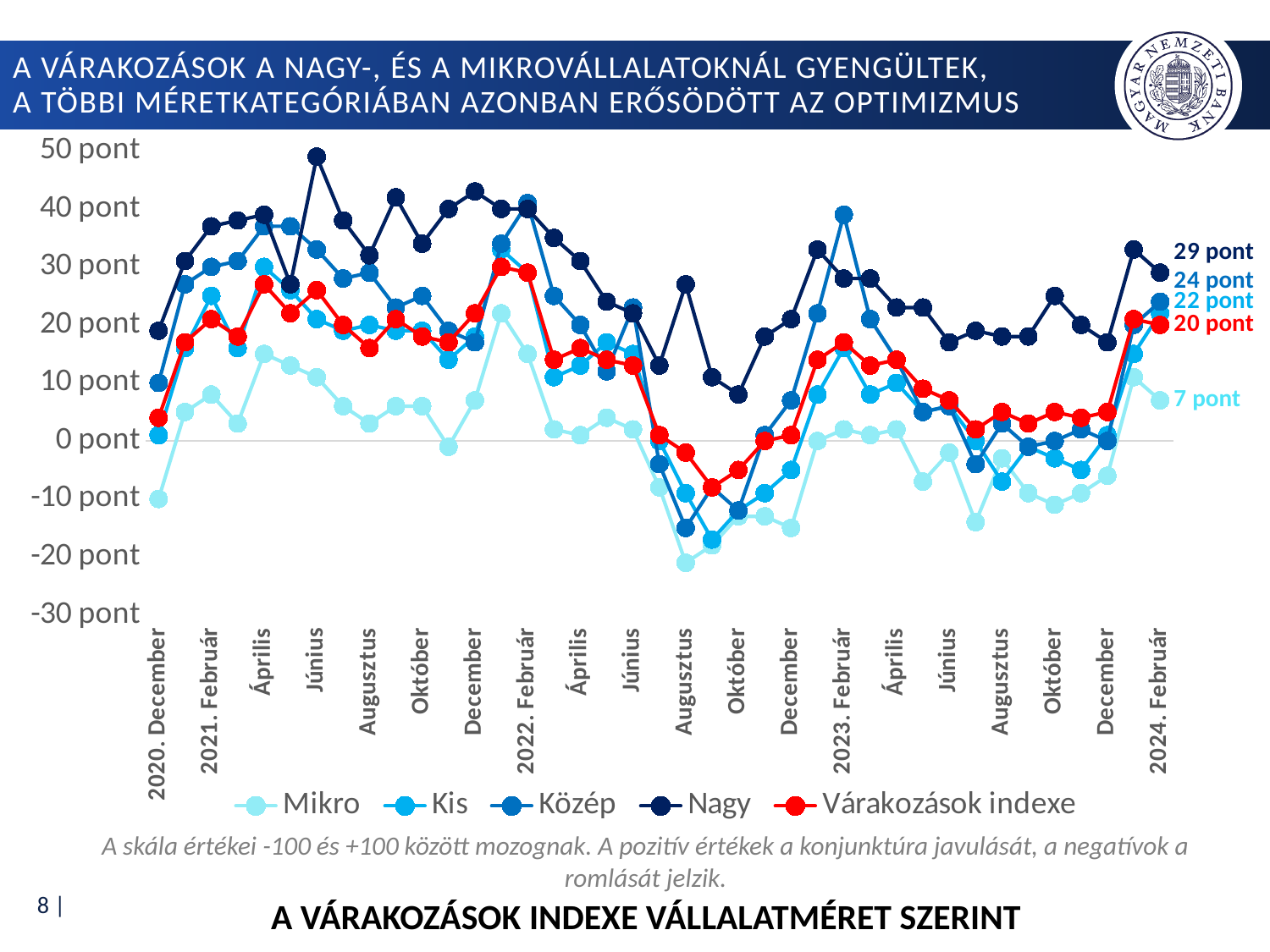
What is the value of the Várakozások indexe series at 2024. Február? 20 pont What kind of chart is shown on the slide? Line chart What is the difference between the Nagy and Mikro values at 2024. Február? 22 pont What is the value of the Mikro series at 2024. Február? 7 pont Is the value for Mikro at 2020. December greater or less than 0 pont? less Which series has the highest value at 2024. Február? Nagy Which series has the lowest value at 2024. Február? Mikro What is the value of the Nagy series at 2024. Február? 29 pont Is the value for Nagy at 2021. Június greater or less than 40 pont? greater At 2024. Február, which is larger: the Kis value or the Várakozások indexe value? Kis How many series does the legend list? 5 What is the value of the Közép series at 2024. Február? 24 pont